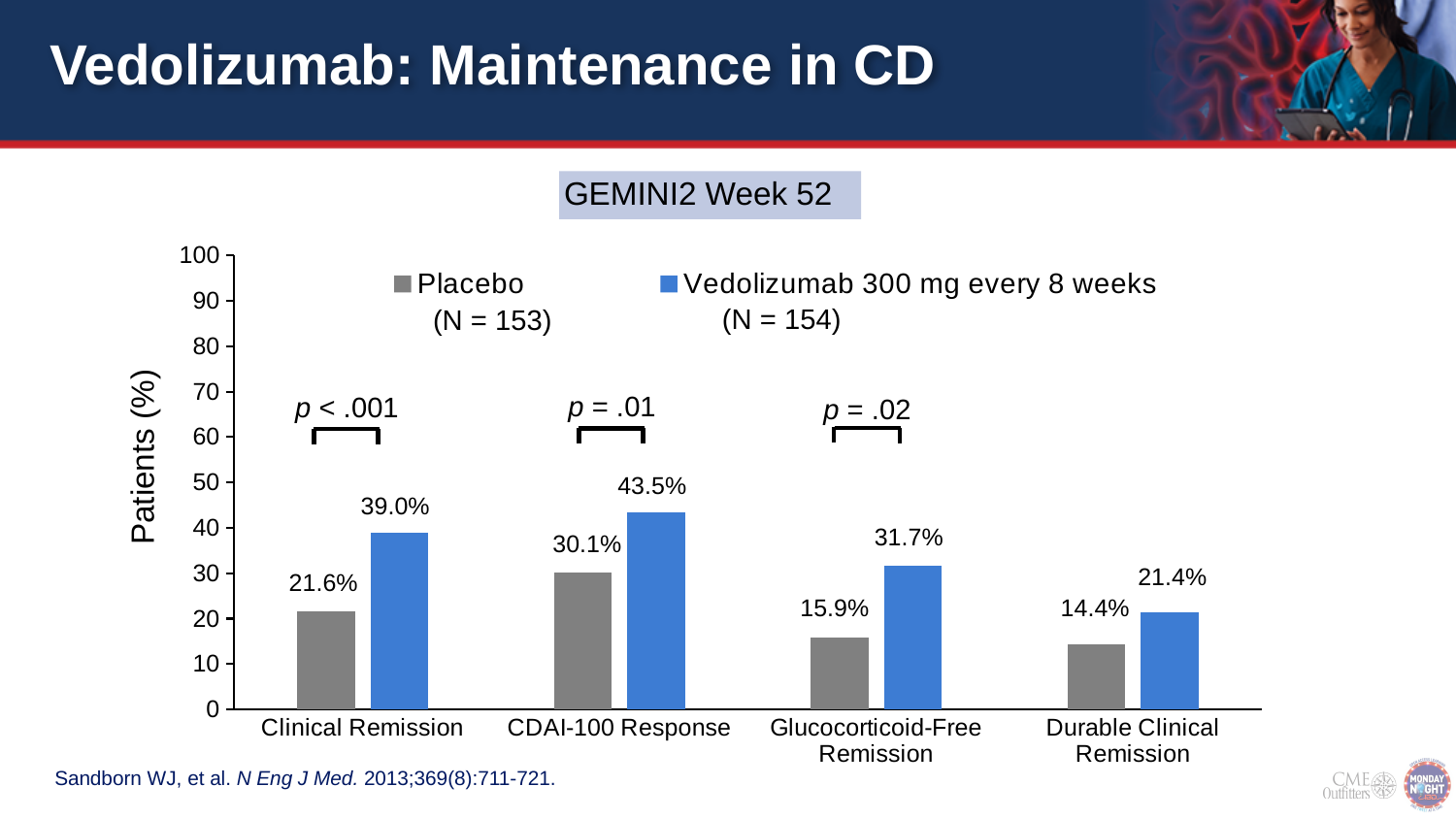
Which category has the lowest value for Placebo? Durable Clinical Remission How many categories are shown on the x axis? 4 What is the p-value shown above the Glucocorticoid-Free Remission bars? p = .02 What is the difference between the Vedolizumab and Placebo values in the Clinical Remission category? 17.4% How many series does the legend list? 2 What kind of chart is shown on the slide? Bar chart What is the value for Placebo in the Clinical Remission category? 21.6% What is the value for Placebo in the Glucocorticoid-Free Remission category? 15.9% What is the value for Vedolizumab 300 mg every 8 weeks in the CDAI-100 Response category? 43.5% Which category has the highest value for Vedolizumab 300 mg every 8 weeks? CDAI-100 Response What is the value for Vedolizumab 300 mg every 8 weeks in the Durable Clinical Remission category? 21.4%